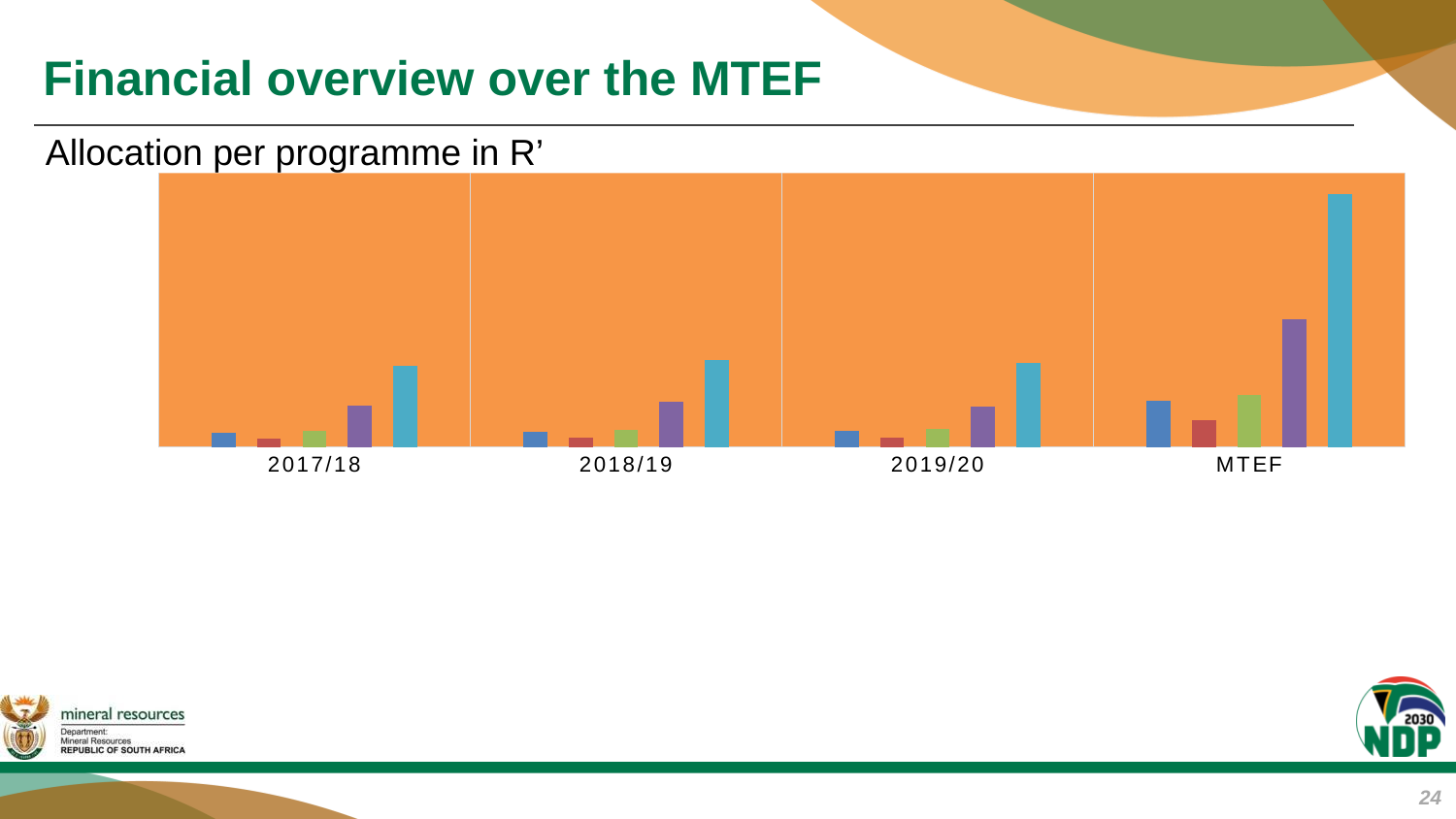
What is the caption written above the chart? Allocation per programme in R' In the 2017/18 group, which coloured bar is the shortest? The red bar What kind of chart is shown on the slide? Bar chart In the MTEF group, is the red bar taller or shorter than the green bar? Shorter How many bars are plotted in each category group of the chart? 5 In the MTEF group, is the purple bar taller or shorter than the light blue bar? Shorter In the 2018/19 group, is the light blue bar taller or shorter than the purple bar? Taller Which category on the x axis contains the tallest bar in the chart? MTEF How many categories are shown along the x axis of the chart? 4 In the MTEF group, which coloured bar is the tallest? The light blue (teal) bar What is the background colour of the chart's plot area? Orange